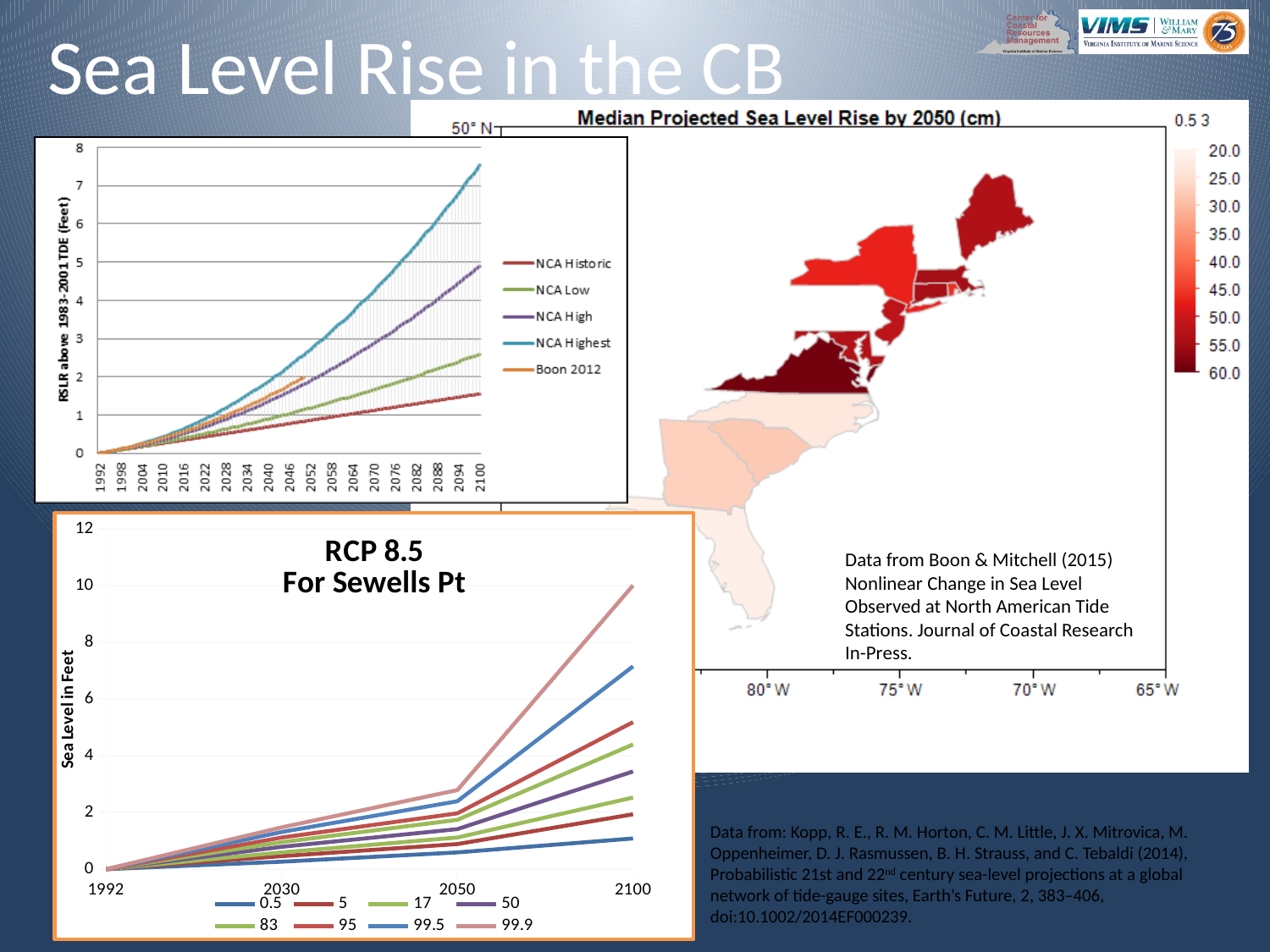
What kind of chart is the 'RCP 8.5 For Sewells Pt' chart at the bottom left of the slide? line chart In the 'RCP 8.5 For Sewells Pt' chart, is the value of the 0.5 series at 2100 greater or less than 2? less In the 'RCP 8.5 For Sewells Pt' chart, how many years are marked on the x axis? 4 In the 'RCP 8.5 For Sewells Pt' chart, is the value of the 99.9 series at 2100 greater or less than 8? greater In the top-left chart (RSLR above 1983-2001 TDE), which series reaches the highest value at 2100? NCA Highest How many series does the legend of the top-left chart (RSLR above 1983-2001 TDE) list? 5 In the 'RCP 8.5 For Sewells Pt' chart, do the series values rise or fall from 1992 to 2100? rise What is the title of the map chart on the right side of the slide? Median Projected Sea Level Rise by 2050 (cm) How many series does the legend of the 'RCP 8.5 For Sewells Pt' chart list? 8 In the 'RCP 8.5 For Sewells Pt' chart, which series has the highest value at 2100? 99.9 In the 'RCP 8.5 For Sewells Pt' chart, which series has the lowest value at 2100? 0.5 In the top-left chart (RSLR above 1983-2001 TDE), is the value of NCA Historic at 2100 greater or less than 2? less